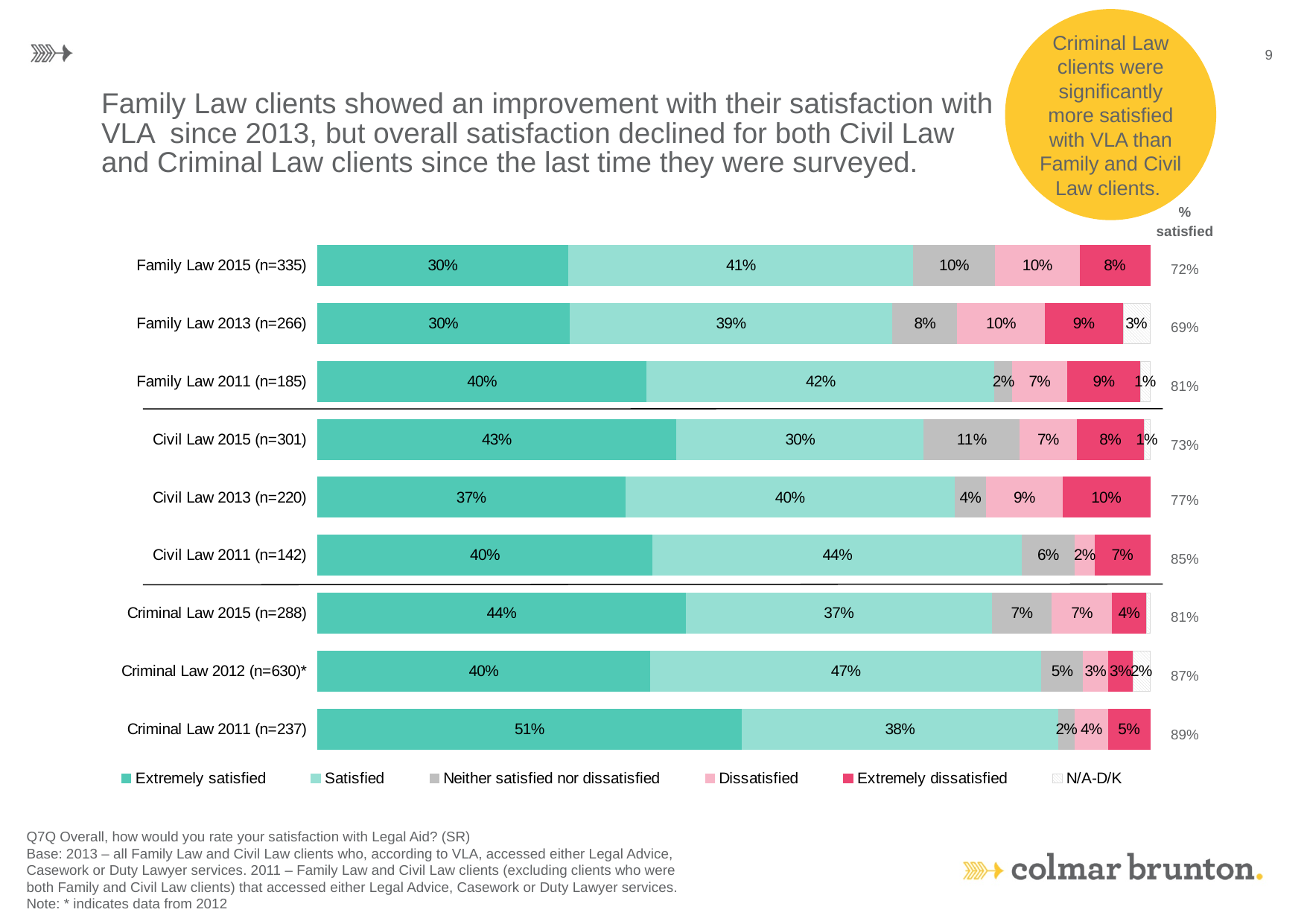
What percentage of Criminal Law 2011 (n=237) clients were Extremely satisfied? 51% Which has a larger Extremely dissatisfied value, Civil Law 2013 (n=220) or Criminal Law 2015 (n=288)? Civil Law 2013 (n=220) How many series does the legend list? 6 Which category has the lowest Satisfied value? Civil Law 2015 (n=301) What is the % satisfied figure shown at the right for Criminal Law 2012 (n=630)*? 87% What is the Satisfied value for Criminal Law 2012 (n=630)*? 47% What kind of chart is shown on the slide? Stacked bar chart Which category has the highest Extremely satisfied value? Criminal Law 2011 (n=237) Which category has the highest % satisfied figure? Criminal Law 2011 (n=237) What is the N/A-D/K value shown for Family Law 2013 (n=266)? 3% What is the difference in the Extremely satisfied value between Civil Law 2015 (n=301) and Civil Law 2013 (n=220)? 6 percentage points How many categories (bars) are shown in the chart? 9